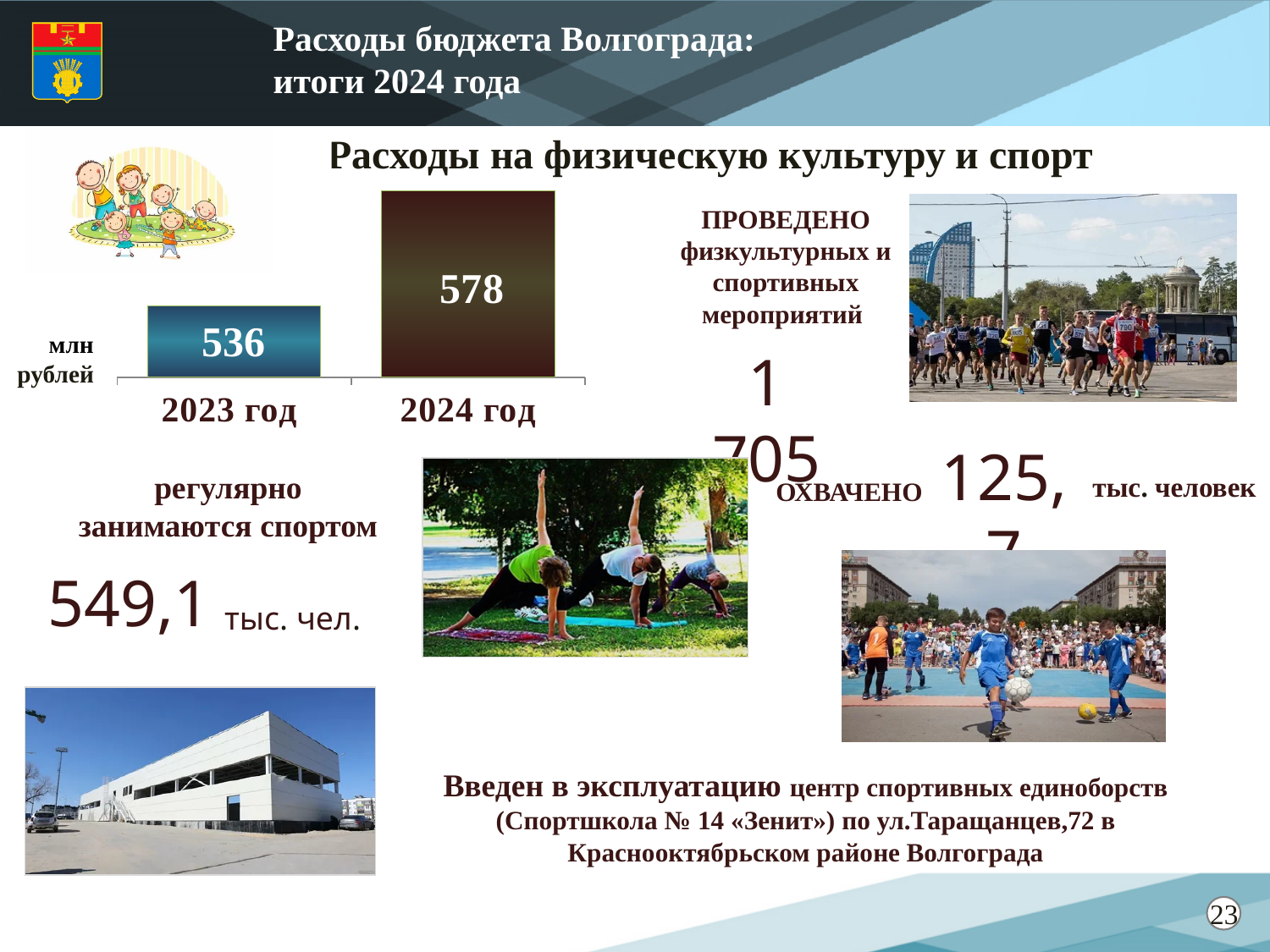
What type of chart is shown on the slide? bar chart Do the values in the bar chart rise or fall from 2023 год to 2024 год? rise What is the title above the bar chart? Расходы на физическую культуру и спорт What is the difference between the 2024 год and 2023 год values in the bar chart? 42 Which year has the lower value in the bar chart? 2023 год How many bars are shown in the chart? 2 Is the value for 2023 год larger or smaller than the value for 2024 год? smaller What is the value for 2023 год in the bar chart? 536 Which year has the higher value in the bar chart? 2024 год What is the value for 2024 год in the bar chart? 578 What unit is indicated for the values in the bar chart? млн рублей